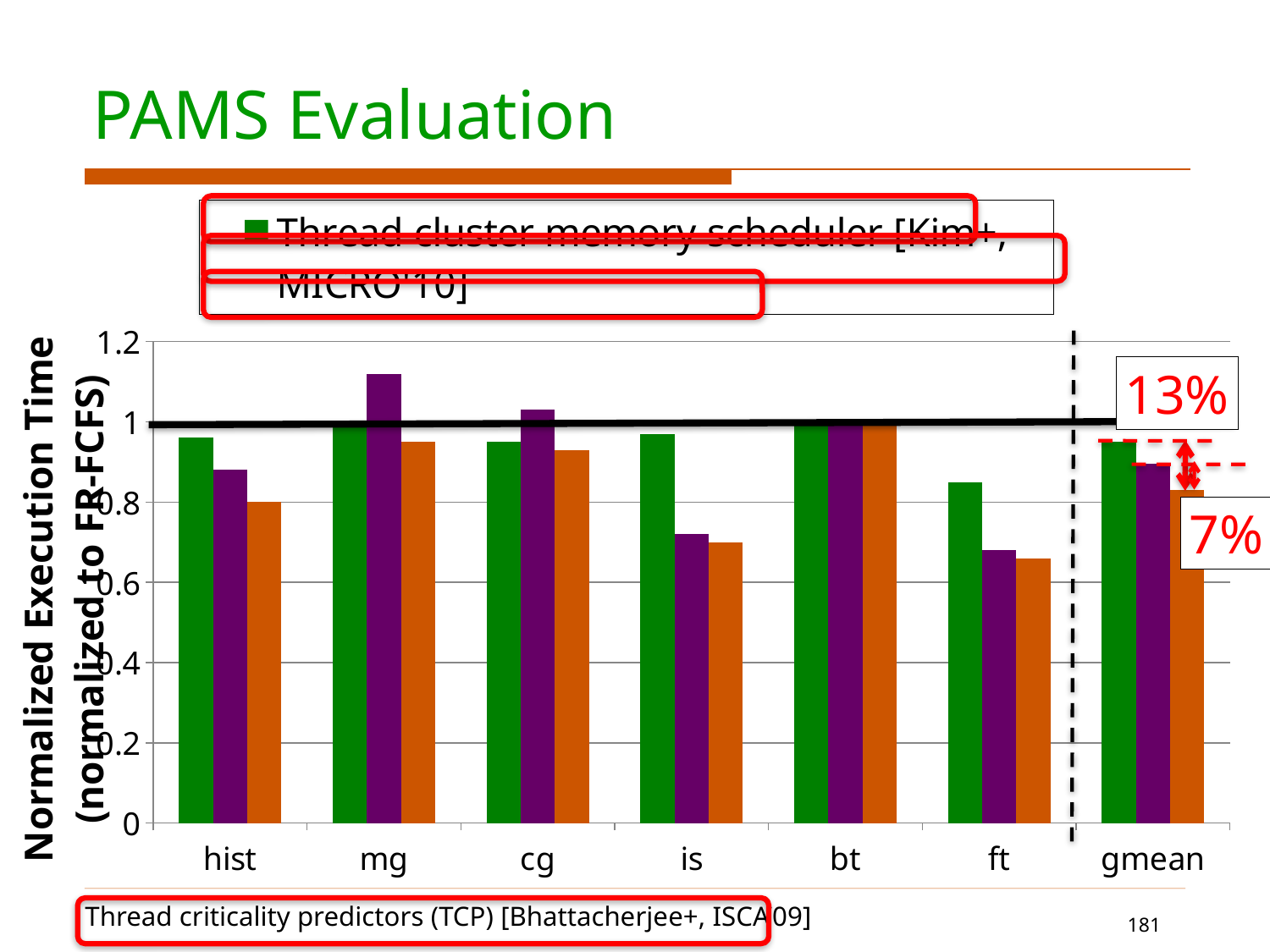
How many bar series (colours) are plotted for each category? 3 What is the title of the y axis? Normalized Execution Time (normalized to FR-FCFS) Is the orange bar for is greater or less than 0.8? less Is the purple bar for mg greater or less than 1? greater Which category has the tallest purple bar? mg How many categories are shown along the x axis of the chart? 7 Is the green bar for hist greater or less than 0.8? greater What kind of chart is shown on the slide? bar chart For hist, which is taller: the green bar or the orange bar? green What two percentage values are annotated next to the gmean bars? 13% and 7% Which category has a taller orange bar: hist or is? hist